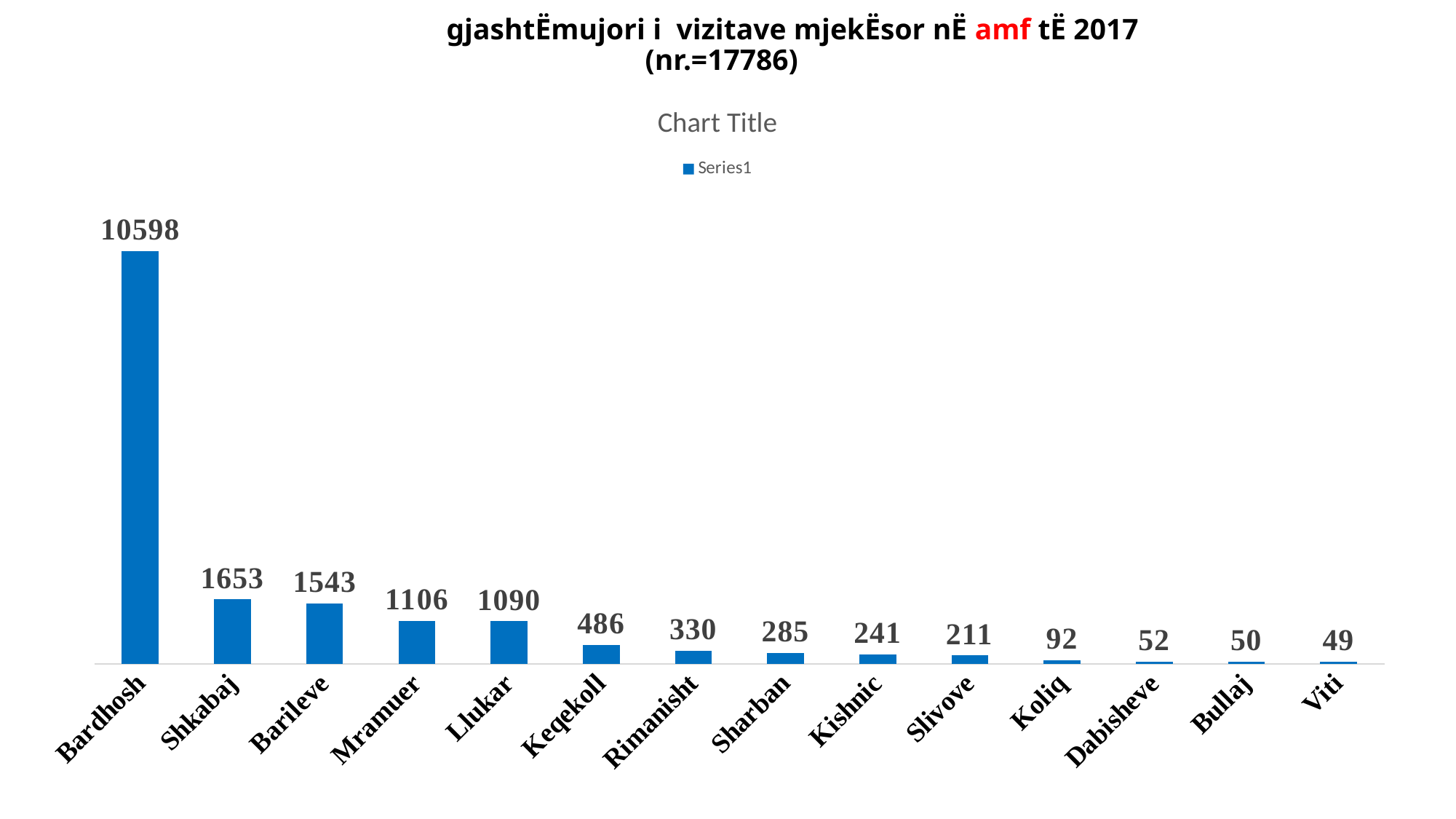
How many categories are shown on the x axis? 14 Which category has the highest value? Bardhosh How many series does the legend list? 1 What is the value for Bardhosh? 10598 What is the value for Keqekoll? 486 What is the difference between the values for Mramuer and Llukar? 16 What is the difference between the values for Shkabaj and Barileve? 110 What is the value for Dabisheve? 52 Which category has the lowest value? Viti Which is larger, the value for Rimanisht or the value for Sharban? Rimanisht What is the name of the series shown in the legend? Series1 What kind of chart is shown on the slide? bar chart